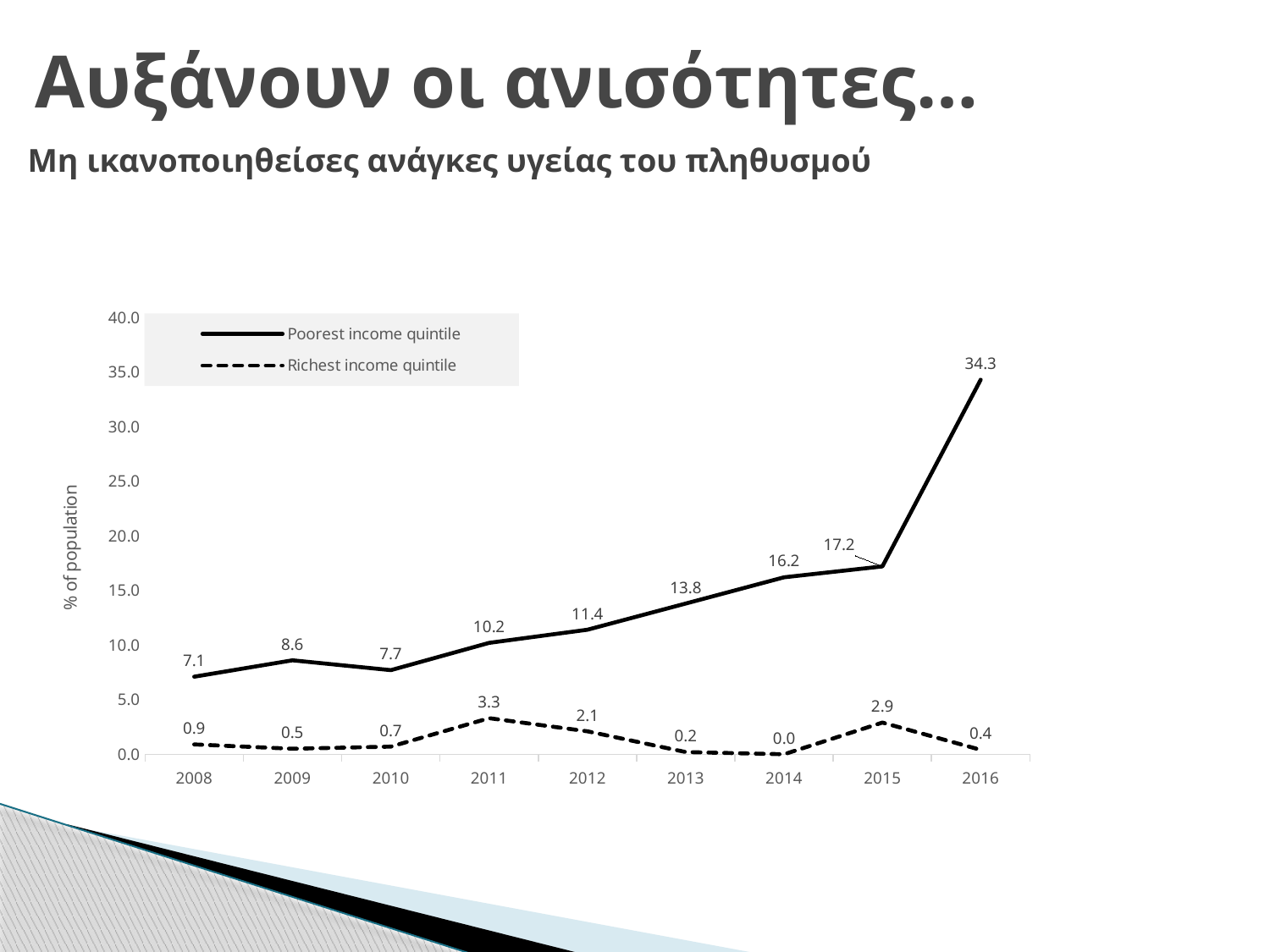
What is the value for the Richest income quintile in 2011? 3.3 How many series does the legend list? 2 What is the value for the Poorest income quintile in 2016? 34.3 In which year is the Poorest income quintile value highest? 2016 Is the value for the Poorest income quintile in 2013 greater or less than 10.0? greater How many years are shown on the x axis? 9 In which year is the Richest income quintile value lowest? 2014 What is the difference between the Poorest and Richest income quintile values in 2016? 33.9 What kind of chart is shown on the slide? Line chart What is the label of the y axis? % of population Which is larger in 2015: the Poorest income quintile value or the Richest income quintile value? Poorest income quintile What is the value for the Poorest income quintile in 2008? 7.1